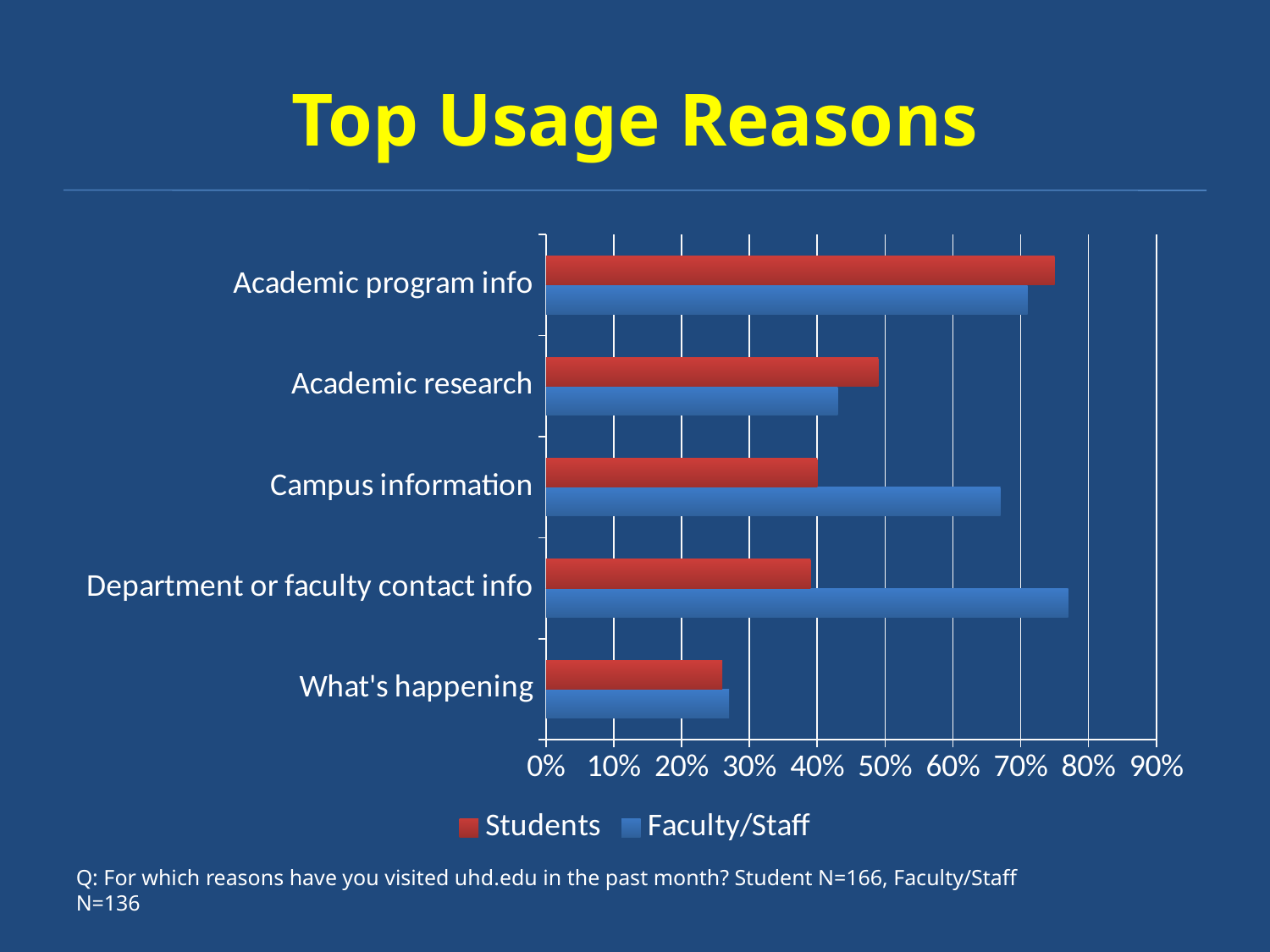
For Academic research, which group has the larger value, Students or Faculty/Staff? Students Which usage reason has the lowest value for Students? What's happening Which usage reason has the lowest value for Faculty/Staff? What's happening How many categories (usage reasons) are shown on the chart? 5 Is the Students value for Academic program info greater or less than 70%? greater Which usage reason has the highest value for Students? Academic program info Which usage reason has the highest value for Faculty/Staff? Department or faculty contact info What type of chart is shown on the slide? Bar chart Which colour represents the Students series in the chart? Red How many series does the legend list? 2 For Campus information, which group has the larger value, Students or Faculty/Staff? Faculty/Staff Is the Faculty/Staff value for Department or faculty contact info greater or less than 70%? greater